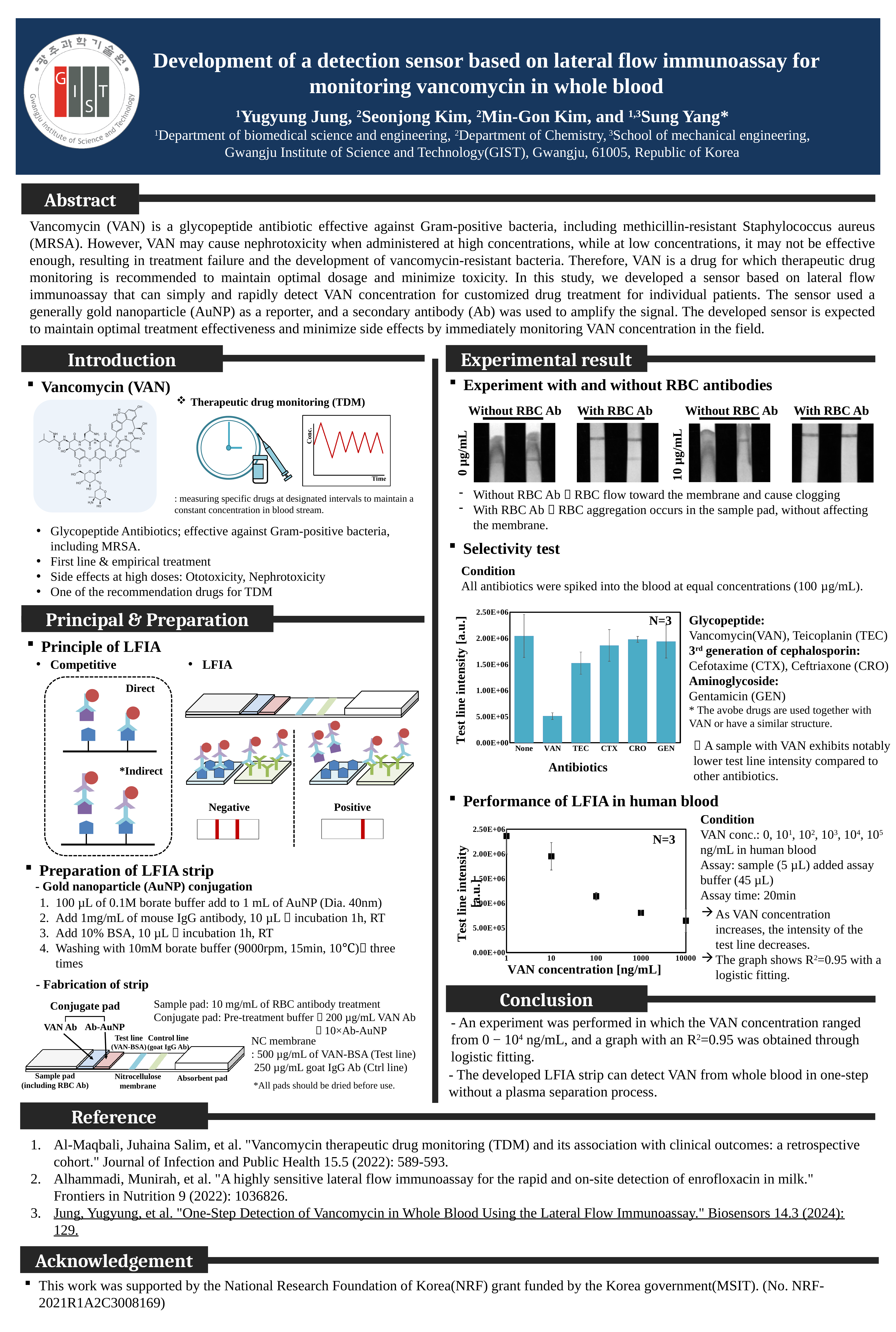
In the performance of LFIA in human blood chart, how many data points are plotted? 5 In the selectivity test bar chart, how many antibiotic categories are shown on the x axis? 6 What kind of chart is the selectivity test chart (the one with the x axis labelled Antibiotics)? bar chart In the performance of LFIA in human blood chart, how do test line intensity values change as VAN concentration increases along the x axis? They decrease In the selectivity test bar chart, is the value for TEC greater or less than 1.00E+06? greater In the selectivity test bar chart, is the value for None greater or less than 1.50E+06? greater In the selectivity test bar chart, is the value for VAN greater or less than 1.00E+06? less In the selectivity test bar chart, which has the larger test line intensity, VAN or TEC? TEC In the selectivity test bar chart, which category has the lowest test line intensity? VAN What is the x-axis title of the selectivity test bar chart? Antibiotics